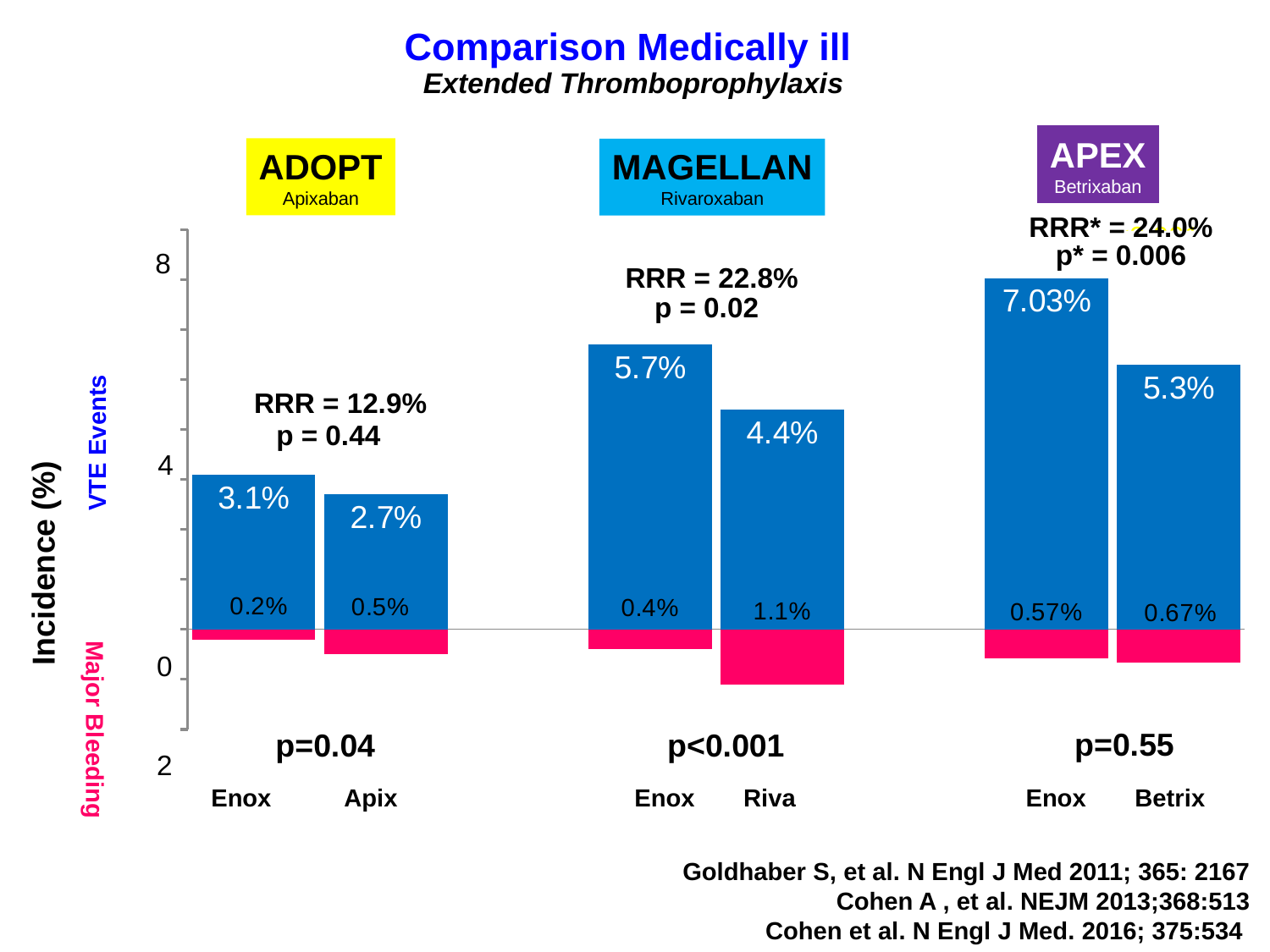
What is the major bleeding incidence for Riva in the MAGELLAN trial? 1.1% What is the VTE event incidence for Enox in the ADOPT trial? 3.1% What is the VTE event incidence for Riva in the MAGELLAN trial? 4.4% What is the RRR value shown for the MAGELLAN trial? 22.8% What is the difference in VTE event incidence between Enox and Riva in the MAGELLAN trial? 1.3% What type of chart is shown on the slide? Bar chart What is the major bleeding incidence for Betrix in the APEX trial? 0.67% Which bar has the lowest major bleeding incidence on the chart? Enox in ADOPT (0.2%) Which has the higher major bleeding incidence in the ADOPT trial, Enox or Apix? Apix What is the difference in VTE event incidence between Enox and Betrix in the APEX trial? 1.73% Is the VTE event incidence for Enox in the MAGELLAN trial greater or less than 4? greater Which bar has the highest VTE event incidence on the chart? Enox in APEX (7.03%)